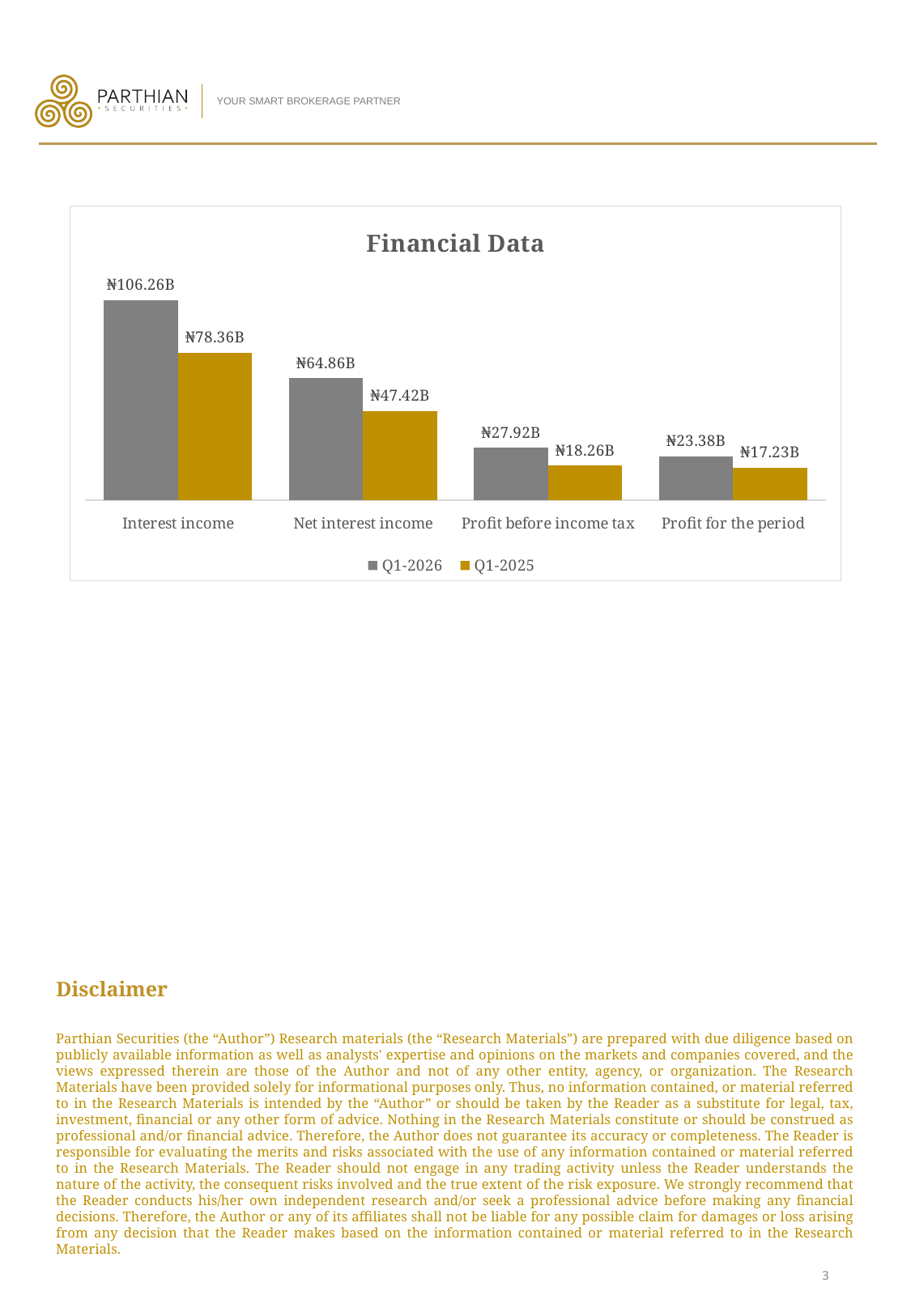
What kind of chart is shown? Bar chart What is the Q1-2026 value for Interest income? ₦106.26B What is the Q1-2026 value for Profit before income tax? ₦27.92B Which is larger: the Q1-2025 value for Interest income or the Q1-2026 value for Net interest income? Q1-2025 Interest income How many series does the legend list? 2 What is the Q1-2025 value for Profit for the period? ₦17.23B Which category has the lowest Q1-2025 value? Profit for the period What is the difference between the Q1-2026 and Q1-2025 values for Profit for the period? ₦6.15B What is the difference between the Q1-2026 and Q1-2025 values for Interest income? ₦27.90B Which category has the highest Q1-2026 value? Interest income How many categories are shown on the x axis? 4 What is the Q1-2025 value for Net interest income? ₦47.42B